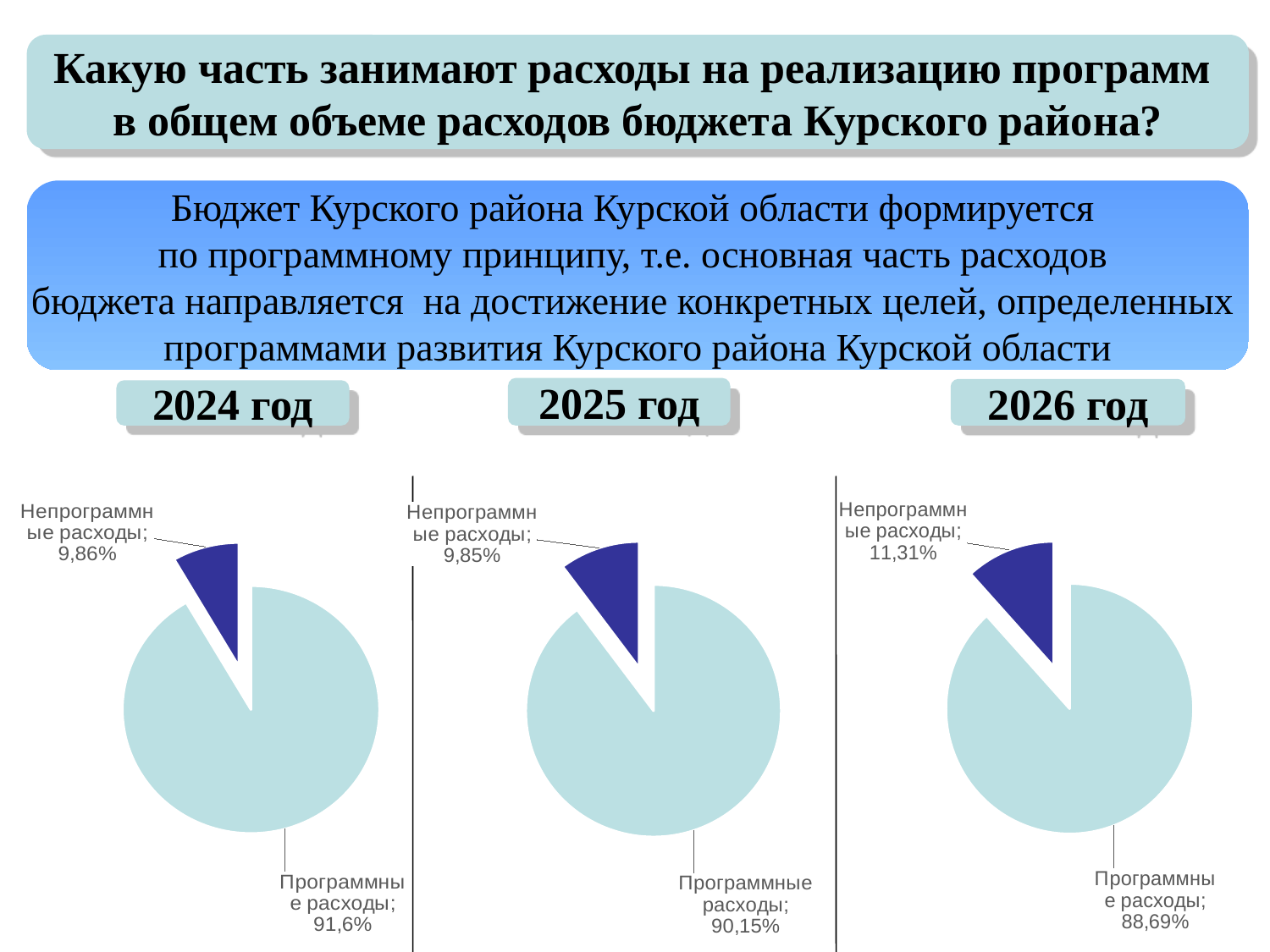
In the 2024 год pie chart, what share is shown for Программные расходы? 91,6% In the 2025 год pie chart, what share is shown for Программные расходы? 90,15% In the 2025 год pie chart, what share is shown for Непрограммные расходы? 9,85% In the 2024 год pie chart, what share is shown for Непрограммные расходы? 9,86% How many pie charts are shown on the slide? 3 Which is larger: the share of Непрограммные расходы in the 2026 год chart or in the 2025 год chart? 2026 год In the 2026 год pie chart, what share is shown for Программные расходы? 88,69% In the 2026 год pie chart, which slice is the largest? Программные расходы How many slices does the 2024 год pie chart have? 2 In the 2026 год pie chart, what share is shown for Непрограммные расходы? 11,31% In the 2024 год pie chart, which slice is the smallest? Непрограммные расходы What type of chart is used for the 2025 год data? Pie chart